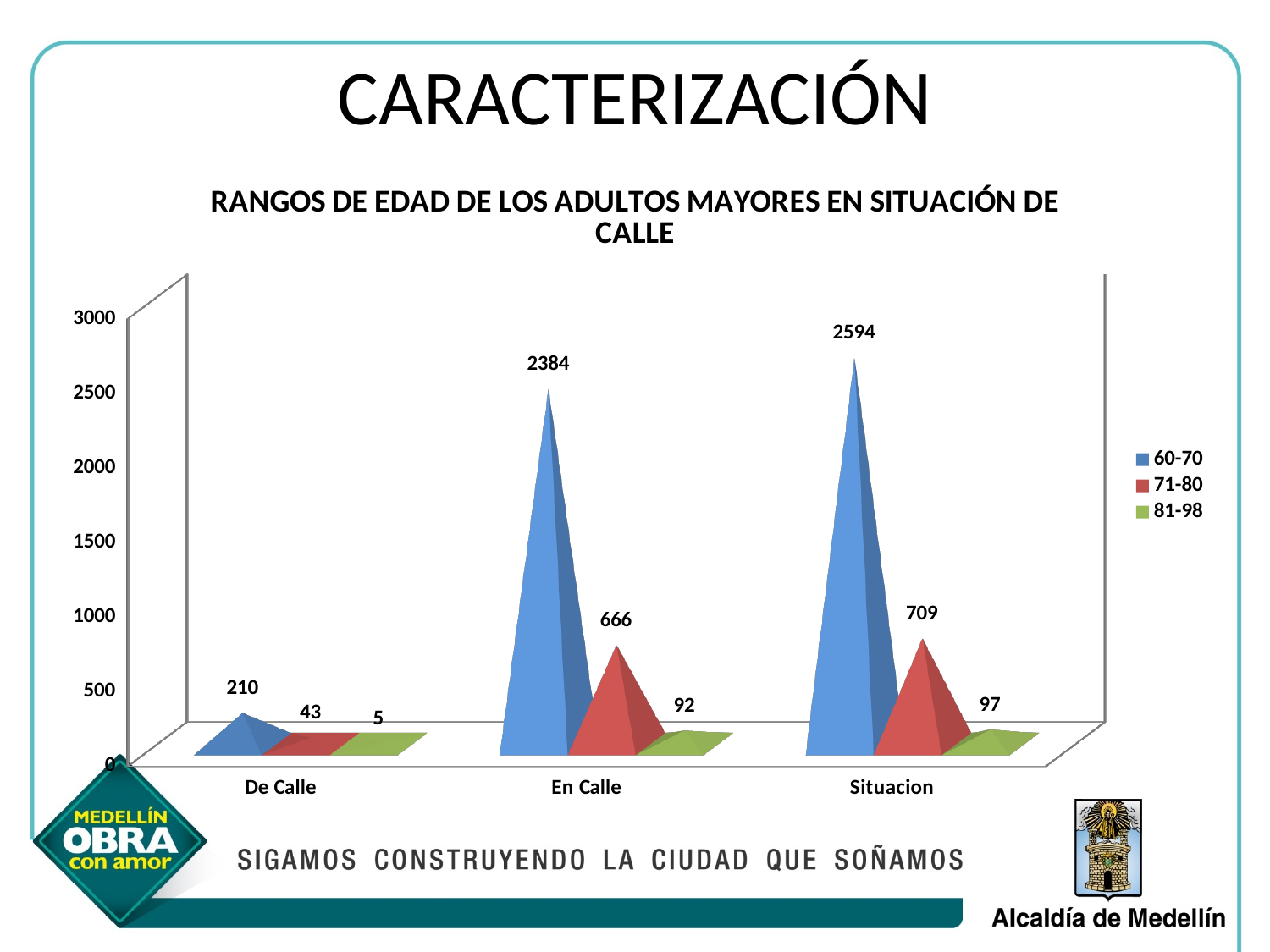
Which category has the lowest value for the 71-80 series? De Calle What is the difference between the 60-70 values for Situacion and En Calle? 210 What is the title of the chart? RANGOS DE EDAD DE LOS ADULTOS MAYORES EN SITUACIÓN DE CALLE What is the total of the three series values for the En Calle category? 3142 What is the value for the 60-70 series in the En Calle category? 2384 Which category has the highest value for the 60-70 series? Situacion Which is larger: the 71-80 value for En Calle or the 71-80 value for Situacion? Situacion How many categories are shown on the x axis? 3 Is the 60-70 value for De Calle greater or less than 500? less How many series does the legend list? 3 What is the value for the 81-98 series in the De Calle category? 5 What is the value for the 71-80 series in the Situacion category? 709